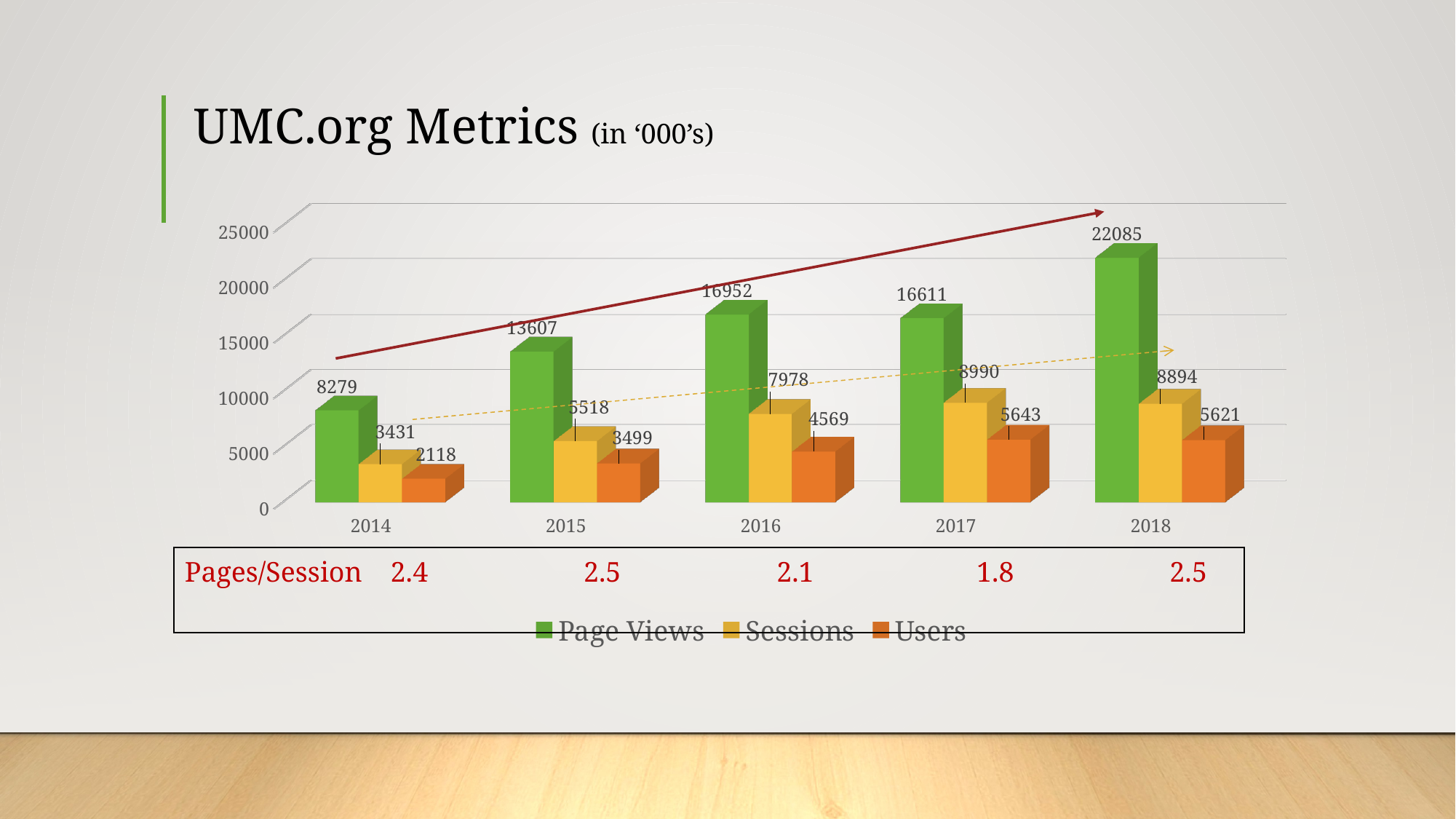
How many years are shown on the x axis? 5 What is the Page Views value for 2018? 22085 Which year has the highest Page Views? 2018 Which year has the lowest Users value? 2014 Is the Page Views value for 2016 greater or less than 15000? greater How many series does the legend list? 3 Which is larger, Sessions in 2017 or Sessions in 2018? Sessions in 2017 What is the Users value for 2014? 2118 What kind of chart is shown on the slide? bar chart What is the difference between Page Views in 2018 and Page Views in 2017? 5474 Which series is shown in green in the legend? Page Views What is the Sessions value for 2016? 7978